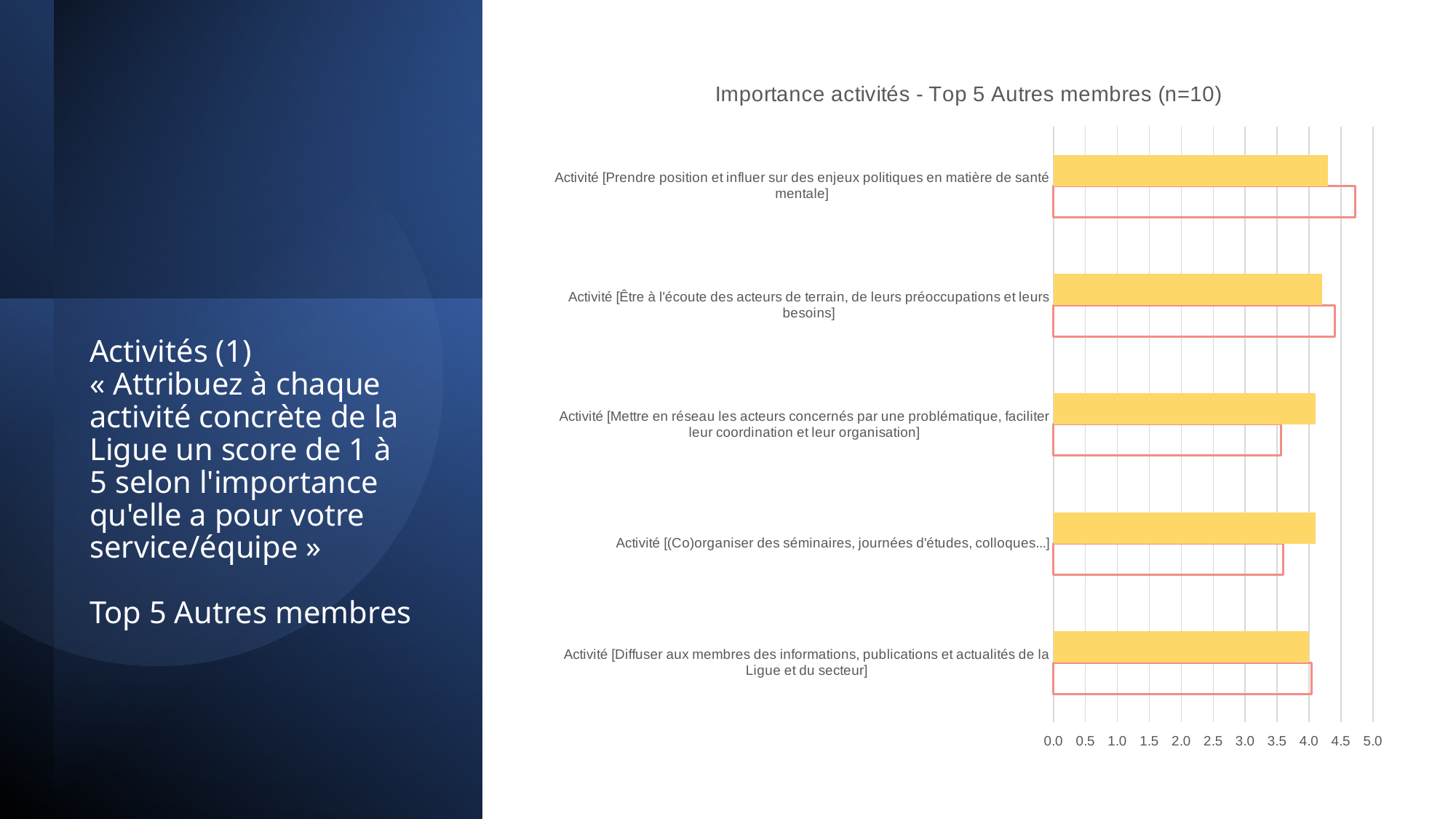
What is the title of the chart? Importance activités - Top 5 Autres membres (n=10) What type of chart is shown on the slide? Bar chart What is the maximum value shown on the horizontal axis of the chart? 5.0 Is the red-outlined bar for 'Mettre en réseau les acteurs concernés par une problématique, faciliter leur coordination et leur organisation' greater or less than 4.0? less Which activity has the longest red-outlined bar? Prendre position et influer sur des enjeux politiques en matière de santé mentale Is the red-outlined bar for 'Prendre position et influer sur des enjeux politiques en matière de santé mentale' greater or less than 4.5? greater Is the yellow bar for 'Être à l'écoute des acteurs de terrain, de leurs préoccupations et leurs besoins' greater or less than 4.0? greater How many activities (categories) are plotted in the chart? 5 For 'Mettre en réseau les acteurs concernés par une problématique', which bar is longer: the yellow bar or the red-outlined bar? The yellow bar How many bars are shown for each activity in the chart? 2